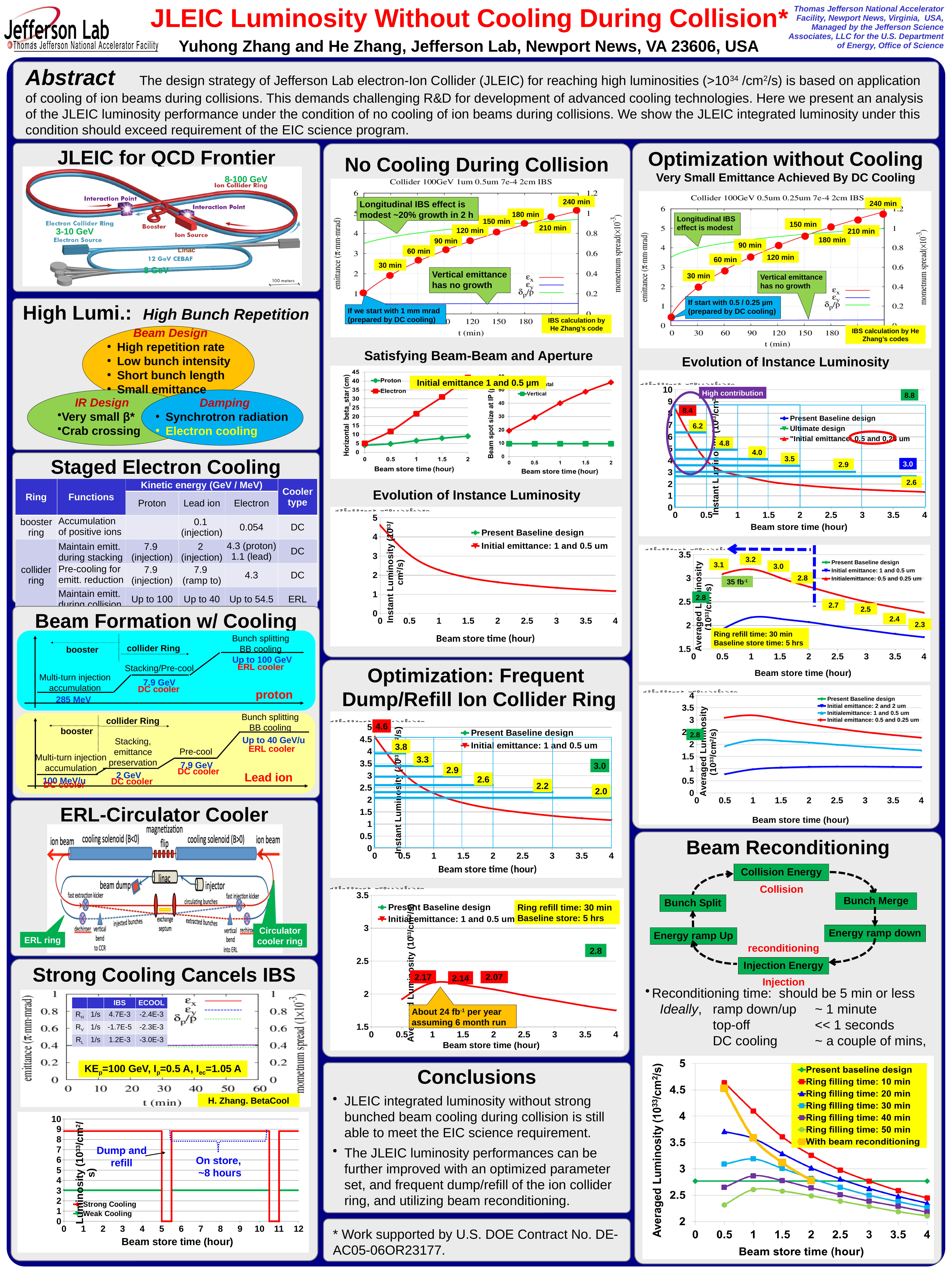
In the 'Beam spot size at IP' chart under 'Satisfying Beam-Beam and Aperture', does the Horizontal series rise or fall with beam store time? rise In the 'Evolution of Instance Luminosity' chart in the middle column, what kind of chart is it? line chart In the 'Evolution of Instance Luminosity' chart in the middle column, does the 'Initial emittance: 1 and 0.5 um' series rise or fall with beam store time? fall In the 'Beam spot size at IP' chart under 'Satisfying Beam-Beam and Aperture', how many series does the legend list? 2 In the bottom-right chart of averaged luminosity versus beam store time, how many series does the legend list? 7 In the 'Horizontal beta_star' chart under 'Satisfying Beam-Beam and Aperture', which series is higher at 2 hours, Proton or Electron? Electron In the bottom-right chart of averaged luminosity versus beam store time, is the value for 'Ring filling time: 50 min' at 0.5 hour greater or less than 2.5? less In the bottom-left chart under 'Strong Cooling Cancels IBS', is the Weak Cooling luminosity greater or less than 4? less In the bottom-left chart under 'Strong Cooling Cancels IBS', which series has the higher luminosity, Strong Cooling or Weak Cooling? Strong Cooling In the 'Evolution of Instance Luminosity' chart in the right column, how many series does the legend list? 3 In the bottom-right chart of averaged luminosity versus beam store time, is the value for 'Ring filling time: 10 min' at 0.5 hour greater or less than 4? greater In the bottom-right chart of averaged luminosity versus beam store time, does the 'Ring filling time: 10 min' series rise or fall as beam store time increases? fall